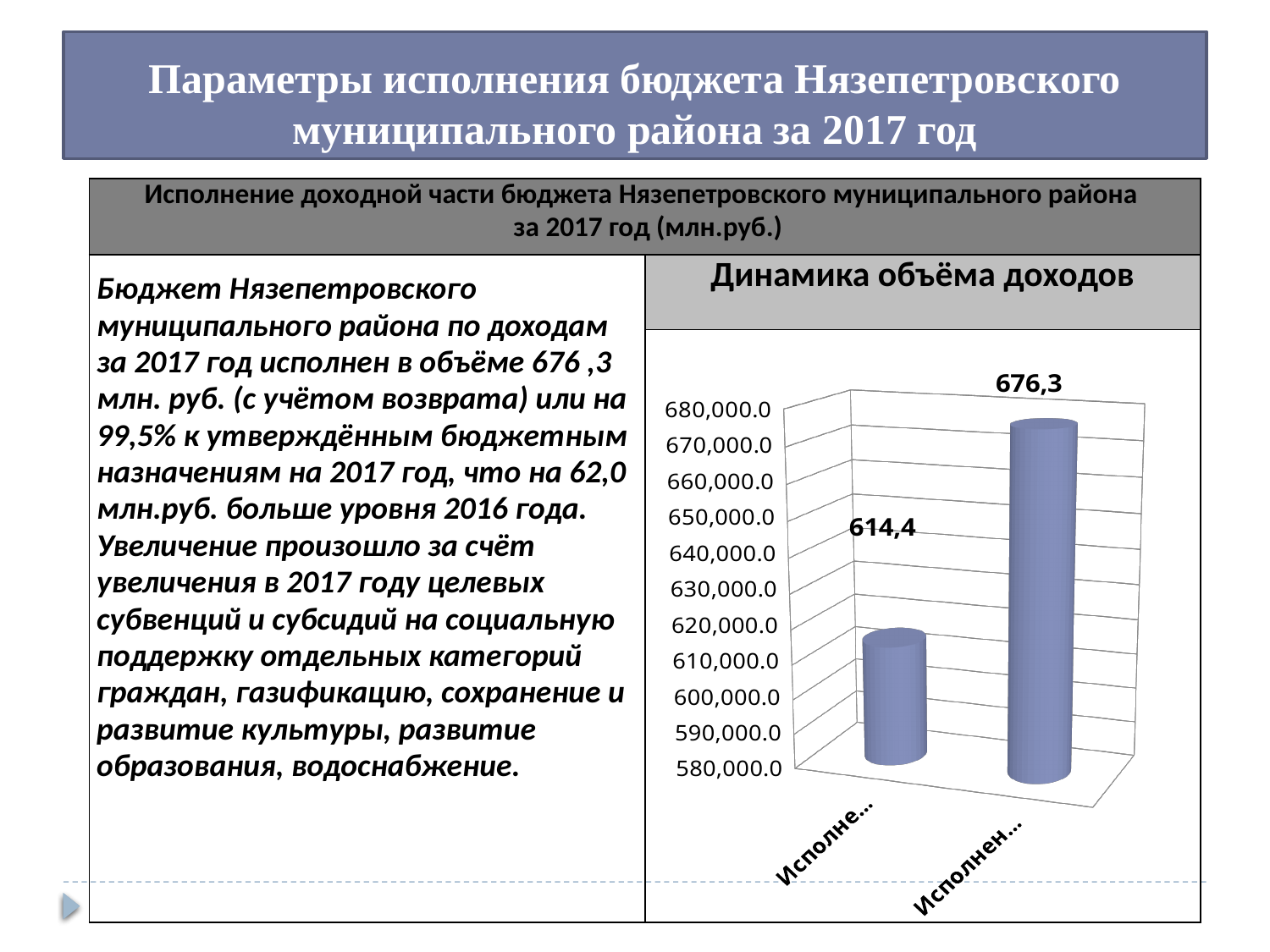
What is the title of the chart on the slide? Динамика объёма доходов Do the values in the chart "Динамика объёма доходов" rise or fall from left to right? rise What is the data label on the right bar of the chart "Динамика объёма доходов"? 676,3 In the chart "Динамика объёма доходов", is the right bar greater or less than 670,000.0 on the axis? greater What is the difference between the right bar's value and the left bar's value in the chart "Динамика объёма доходов"? 61,9 Which bar in the chart "Динамика объёма доходов" has the lowest value? the left bar (614,4) In the chart "Динамика объёма доходов", is the left bar or the right bar larger? the right bar What kind of chart is shown under the title "Динамика объёма доходов"? bar chart Which bar in the chart "Динамика объёма доходов" has the highest value? the right bar (676,3) What is the data label on the left bar of the chart "Динамика объёма доходов"? 614,4 In the chart "Динамика объёма доходов", is the left bar greater or less than 620,000.0 on the axis? less How many bars are plotted in the chart "Динамика объёма доходов"? 2